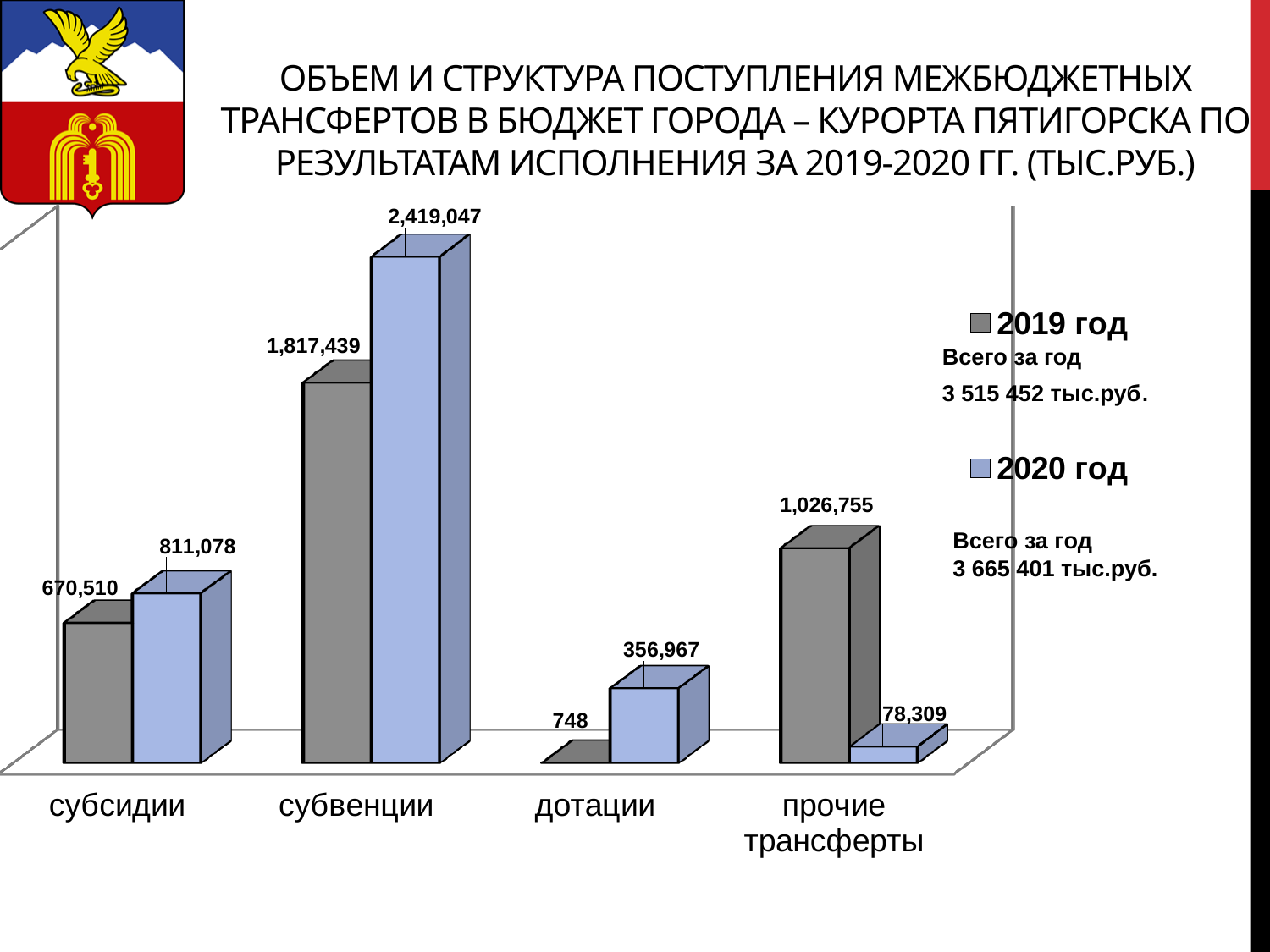
What is the value for субвенции in the 2020 год series? 2,419,047 What is the value for субсидии in the 2019 год series? 670,510 Which category has the highest value in the 2019 год series? субвенции What kind of chart is shown on the slide? bar chart How many series does the legend list? 2 How many categories are shown on the x axis? 4 Which is larger for дотации: the 2019 год value or the 2020 год value? 2020 год What is the difference between the 2019 год and 2020 год values for прочие трансферты? 948,446 Which category has the lowest value in the 2020 год series? прочие трансферты What is the difference between the 2020 год and 2019 год values for субвенции? 601,608 What is the value for прочие трансферты in the 2020 год series? 78,309 What is the value for дотации in the 2019 год series? 748